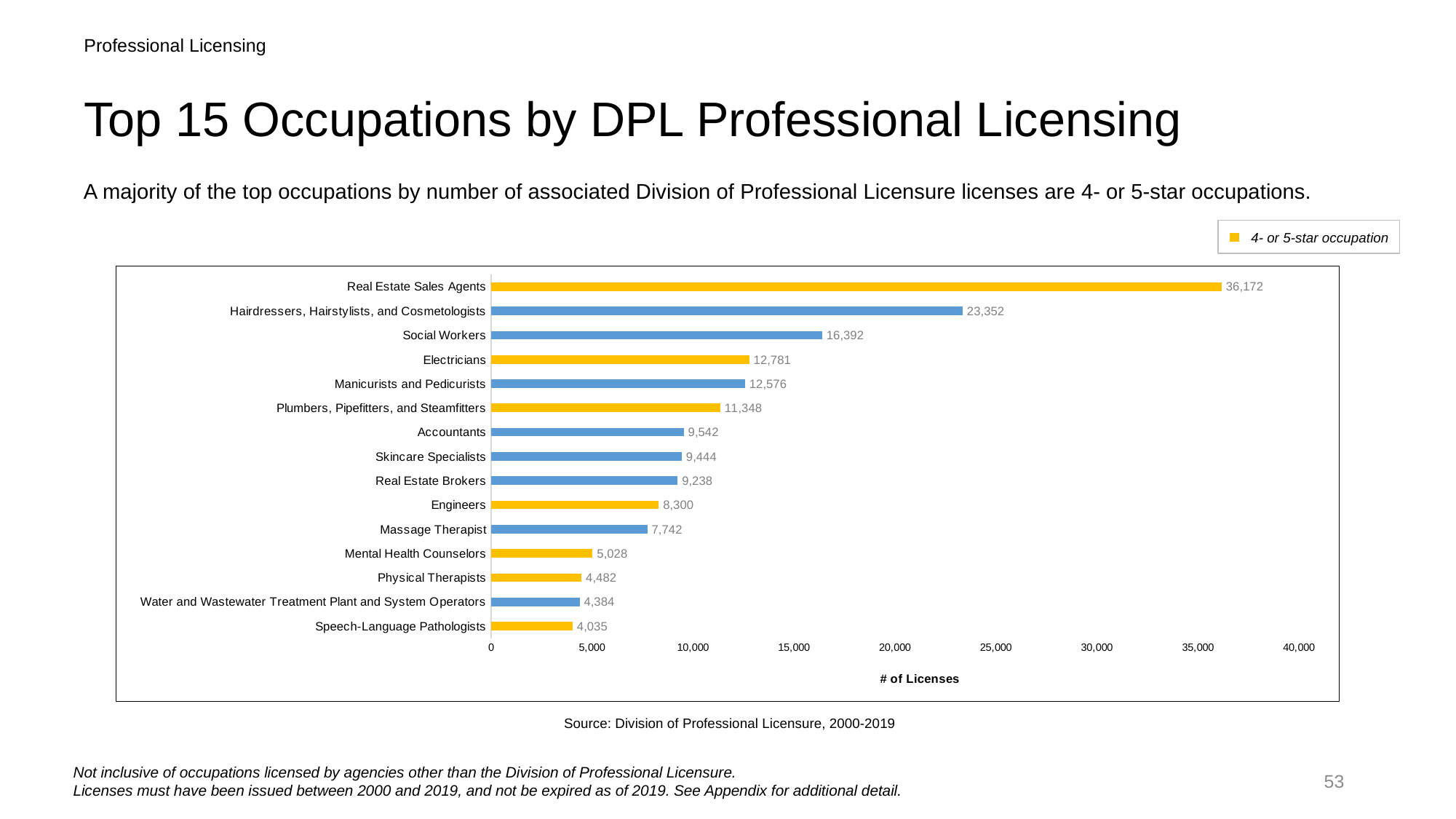
How many occupations are shown in the chart? 15 What is the difference between the values for Electricians and Manicurists and Pedicurists? 205 Is the value for Engineers greater or less than 10,000? less What kind of chart is shown on the slide? bar chart Which occupation has the highest number of licenses? Real Estate Sales Agents What is the difference in licenses between Real Estate Sales Agents and Hairdressers, Hairstylists, and Cosmetologists? 12,820 What does the yellow bar colour indicate according to the legend? 4- or 5-star occupation What is the value for Speech-Language Pathologists? 4,035 Which occupation has the lowest number of licenses? Speech-Language Pathologists Which has more licenses, Social Workers or Plumbers, Pipefitters, and Steamfitters? Social Workers What is the number of licenses for Electricians? 12,781 How many licenses are shown for Real Estate Sales Agents? 36,172